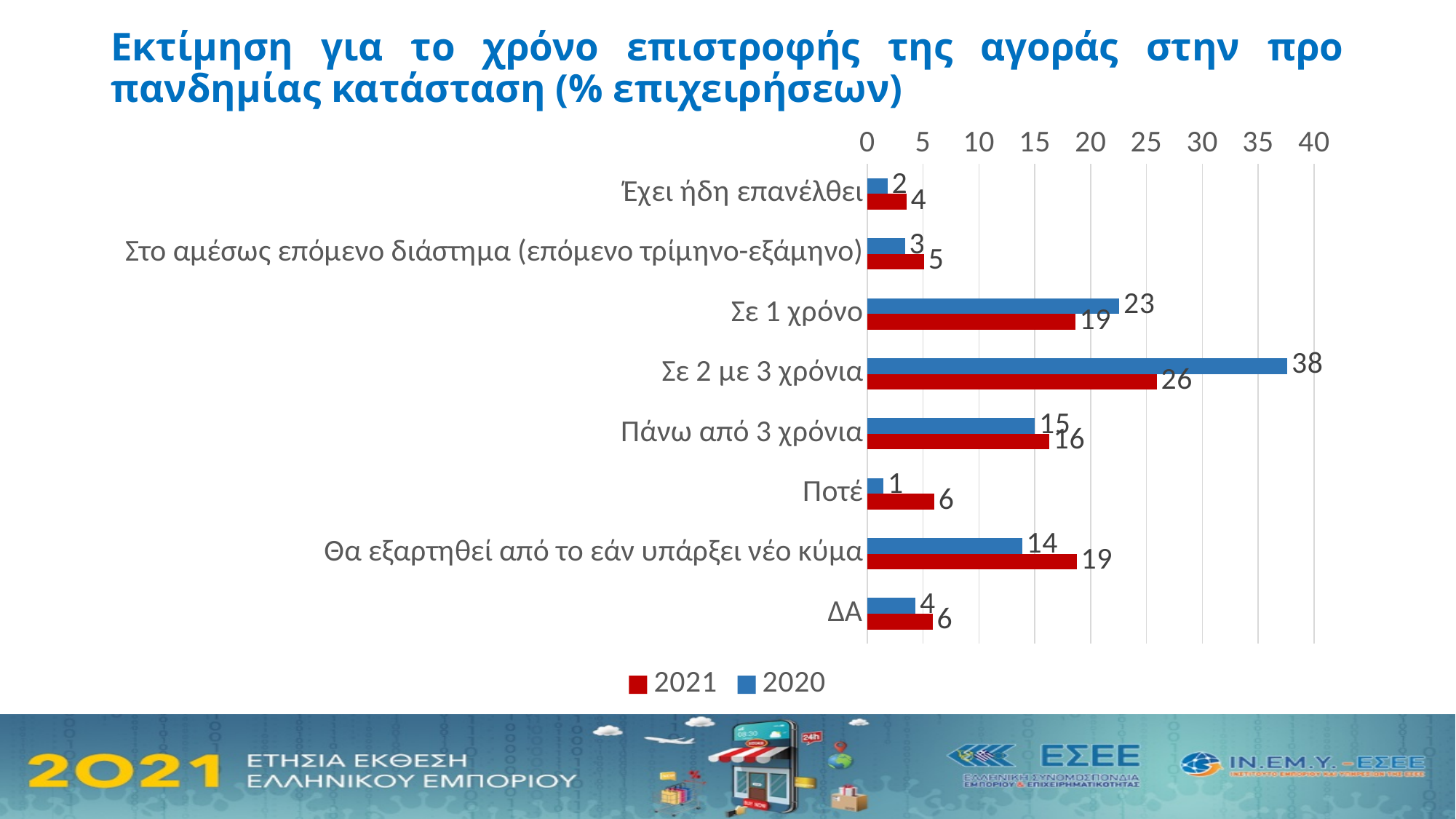
What is the difference between the 2020 and 2021 values for "Σε 2 με 3 χρόνια"? 12 Which is larger for "Θα εξαρτηθεί από το εάν υπάρξει νέο κύμα": the 2020 value or the 2021 value? 2021 Which colour represents the 2021 series in the legend? red Is the 2020 value for "Σε 1 χρόνο" greater or less than 20? greater Which category has the lowest 2020 value? Ποτέ What type of chart is shown on the slide? bar chart What is the 2020 value for "Σε 2 με 3 χρόνια"? 38 How many series does the legend list? 2 Which category has the highest 2021 value? Σε 2 με 3 χρόνια What is the 2021 value for "Ποτέ"? 6 What is the 2021 value for "Σε 1 χρόνο"? 19 How many categories are shown on the chart? 8